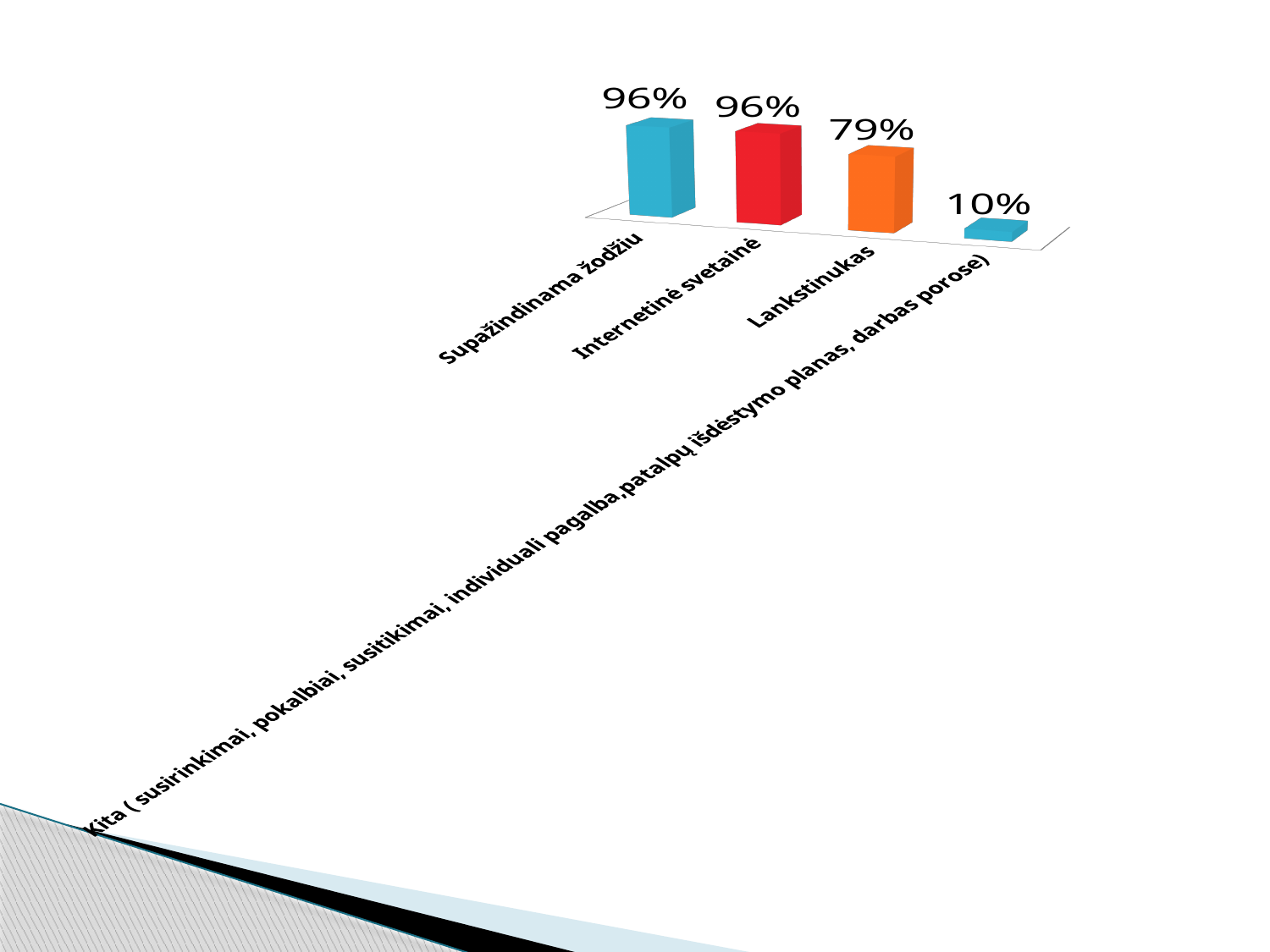
What is the difference between the values for Lankstinukas and Kita? 69 percentage points Which category has the lowest value? Kita What is the value for Internetinė svetainė? 96% How many categories are shown in the chart? 4 What is the difference between the values for Internetinė svetainė and Lankstinukas? 17 percentage points What colour is the bar for Lankstinukas? Orange What is the value for Supažindinama žodžiu? 96% What kind of chart is shown on the slide? Bar chart Which is larger, the value for Lankstinukas or the value for Kita? Lankstinukas What is the value for the Kita category? 10% What is the highest value shown in the chart? 96% What is the value for Lankstinukas? 79%